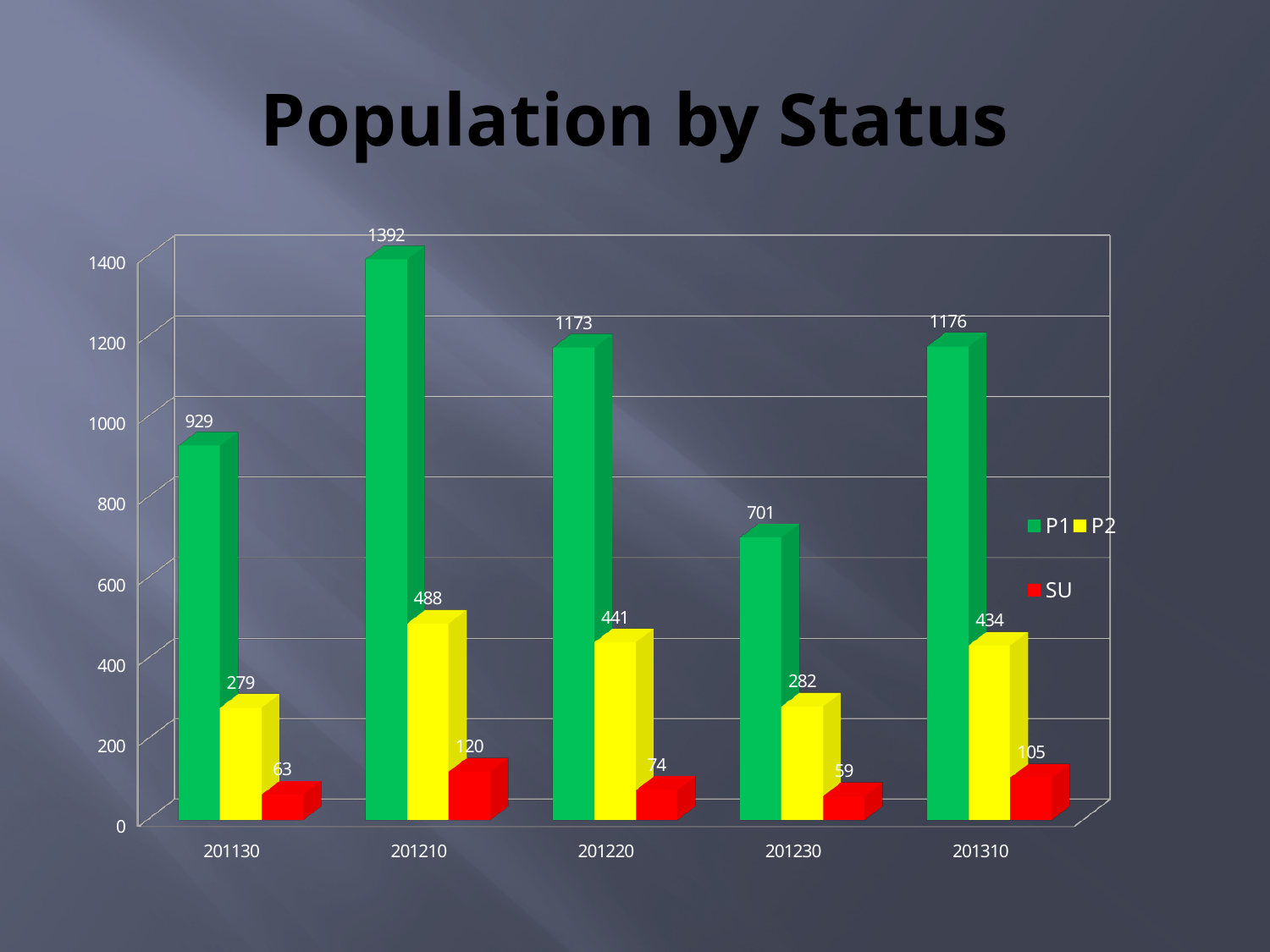
Which is larger, the P2 value for 201210 or the P2 value for 201220? 201210 Which category has the lowest SU value? 201230 What is the P1 value for 201210? 1392 How many categories are shown on the x axis? 5 What kind of chart is shown on the slide? bar chart What is the SU value for 201230? 59 How many series does the legend list? 3 Which category has the highest P1 value? 201210 What is the title of the chart? Population by Status What is the difference between the P1 values for 201210 and 201230? 691 Is the P1 value for 201130 greater or less than 800? greater What is the P2 value for 201310? 434